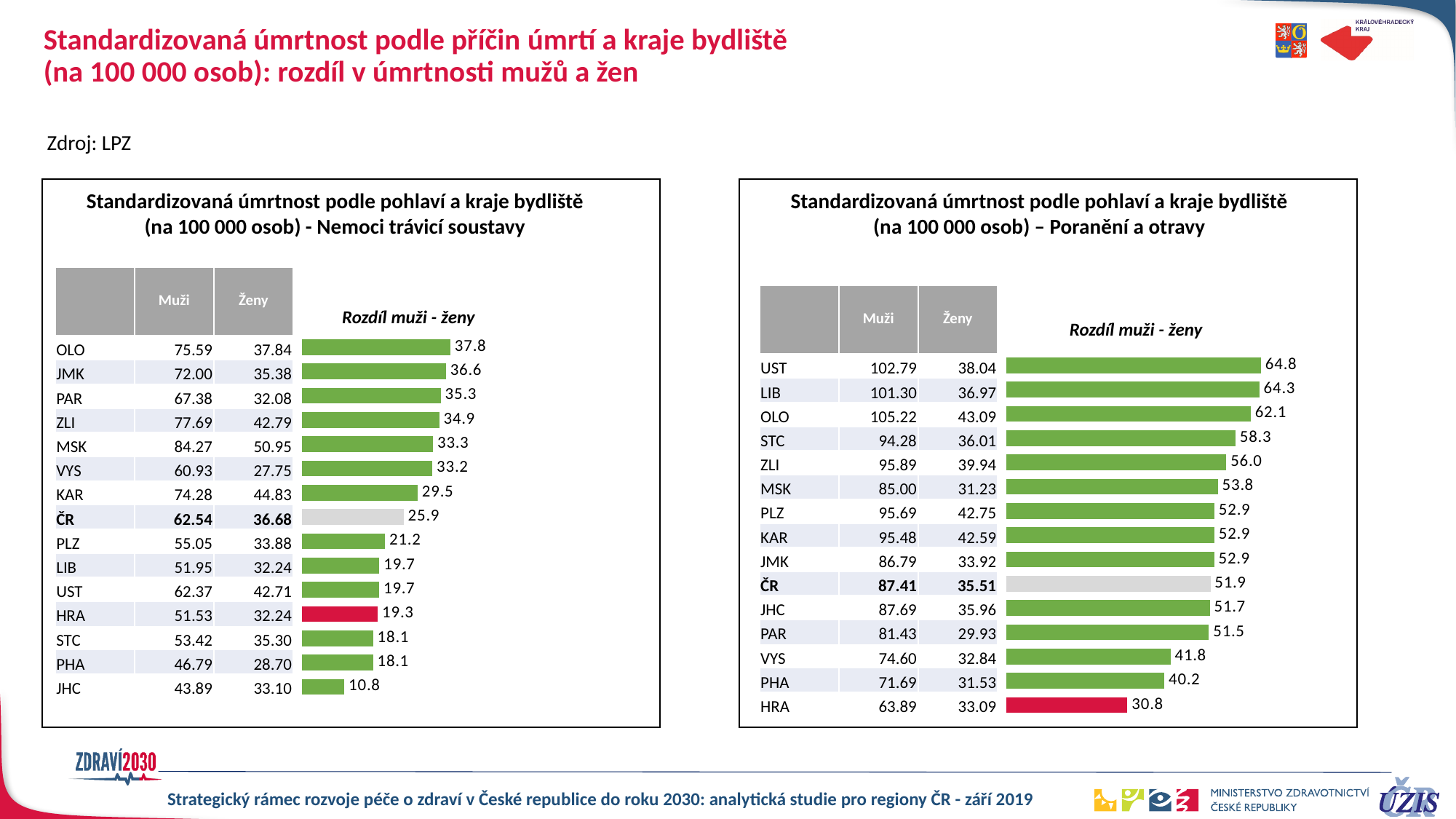
In the left chart (Nemoci trávicí soustavy), how many regions (rows) are plotted, including ČR? 15 In the right chart (Poranění a otravy), what is the 'Rozdíl muži - ženy' value for HRA? 30.8 In the right chart (Poranění a otravy), what is the Ženy value for OLO? 43.09 In the left chart (Nemoci trávicí soustavy), which bar is coloured red? HRA What type of chart is used on the slide to show 'Rozdíl muži - ženy'? Bar chart In the right chart (Poranění a otravy), what is the 'Rozdíl muži - ženy' value for ČR? 51.9 In the left chart (Nemoci trávicí soustavy), what is the difference between the 'Rozdíl muži - ženy' values for OLO and JHC? 27.0 In the left chart (Nemoci trávicí soustavy), what is the Muži value for MSK? 84.27 In the right chart (Poranění a otravy), which is larger, the 'Rozdíl muži - ženy' value for STC or for VYS? STC In the right chart (Poranění a otravy), which region has the highest 'Rozdíl muži - ženy' value? UST In the left chart (Nemoci trávicí soustavy), what is the 'Rozdíl muži - ženy' value for OLO? 37.8 In the left chart (Nemoci trávicí soustavy), which region has the lowest 'Rozdíl muži - ženy' value? JHC